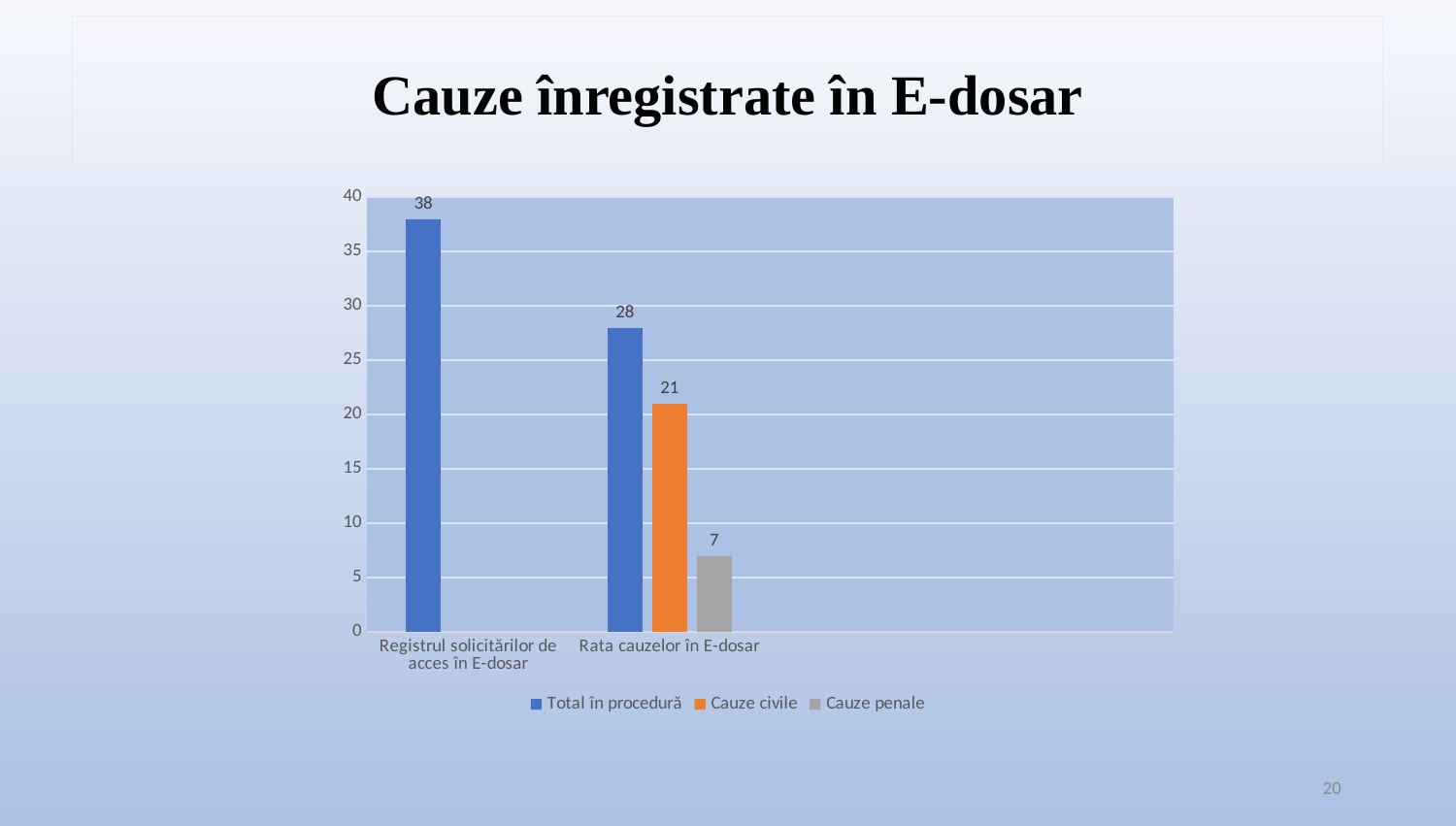
Which is larger for "Rata cauzelor în E-dosar": "Cauze civile" or "Cauze penale"? Cauze civile What is the value of "Total în procedură" for "Registrul solicitărilor de acces în E-dosar"? 38 What is the value of "Total în procedură" for "Rata cauzelor în E-dosar"? 28 What is the value of "Cauze civile" for "Rata cauzelor în E-dosar"? 21 Which series has the lowest value for "Rata cauzelor în E-dosar"? Cauze penale What is the difference between the "Total în procedură" values of the two categories? 10 Which category has the highest "Total în procedură" value? Registrul solicitărilor de acces în E-dosar What is the difference between "Cauze civile" and "Cauze penale" for "Rata cauzelor în E-dosar"? 14 What is the value of "Cauze penale" for "Rata cauzelor în E-dosar"? 7 How many series does the legend list? 3 What kind of chart is shown on the slide? Bar chart What is the title of the slide? Cauze înregistrate în E-dosar